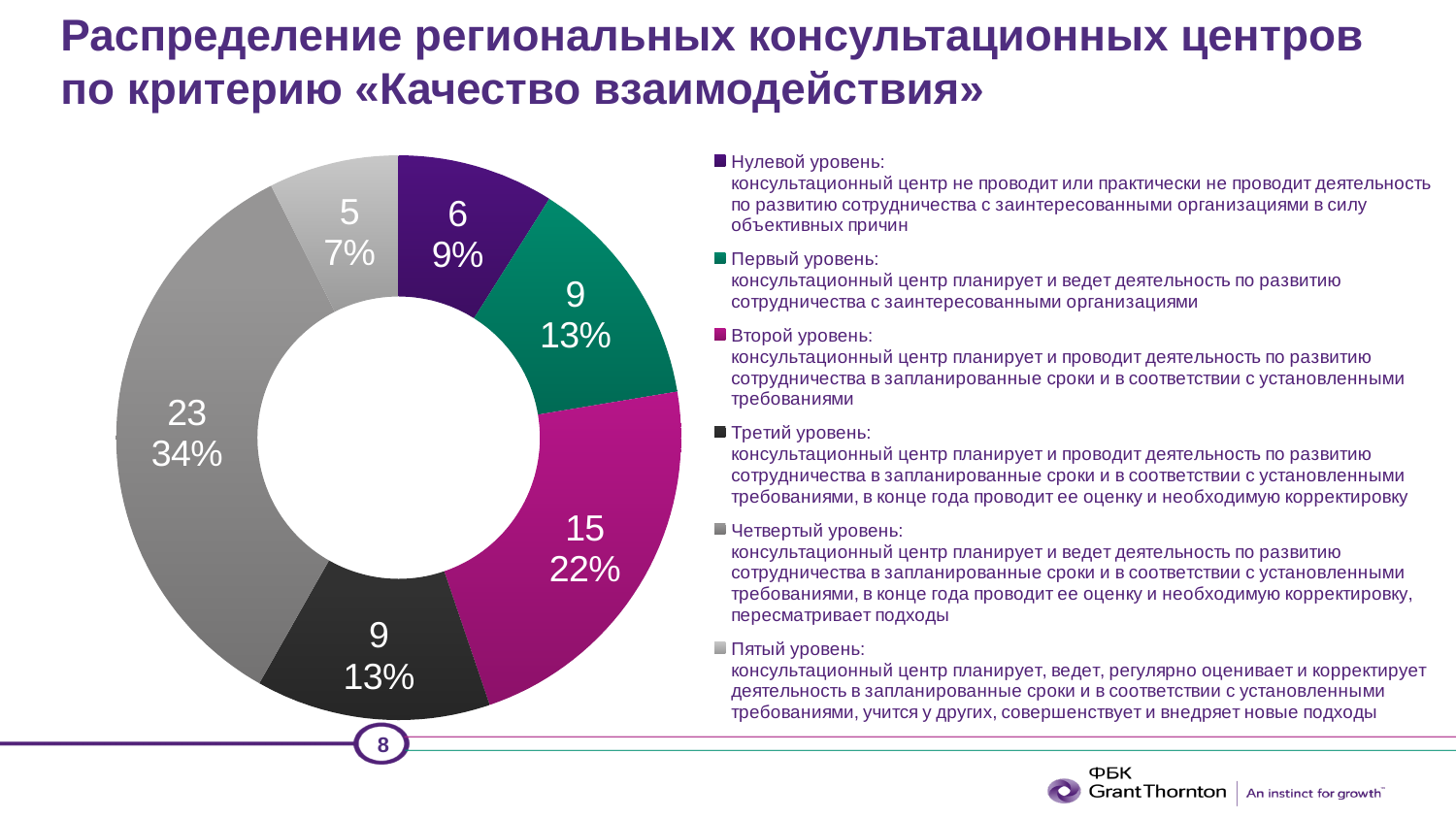
How many entries does the legend list? 6 What is the number of centres for «Четвертый уровень»? 23 What kind of chart is shown on the slide? Doughnut (pie) chart What is the difference in the number of centres between «Четвертый уровень» and «Второй уровень»? 8 Which has more centres, «Нулевой уровень» or «Первый уровень»? Первый уровень Which level has the smallest slice? Пятый уровень What share of the chart does «Второй уровень» represent? 22% What is the number of centres for «Нулевой уровень»? 6 What colour is the slice for «Второй уровень»? Magenta (purple-pink) Which level has the largest slice? Четвертый уровень How many slices does the doughnut chart have? 6 What share of the chart does «Пятый уровень» represent? 7%